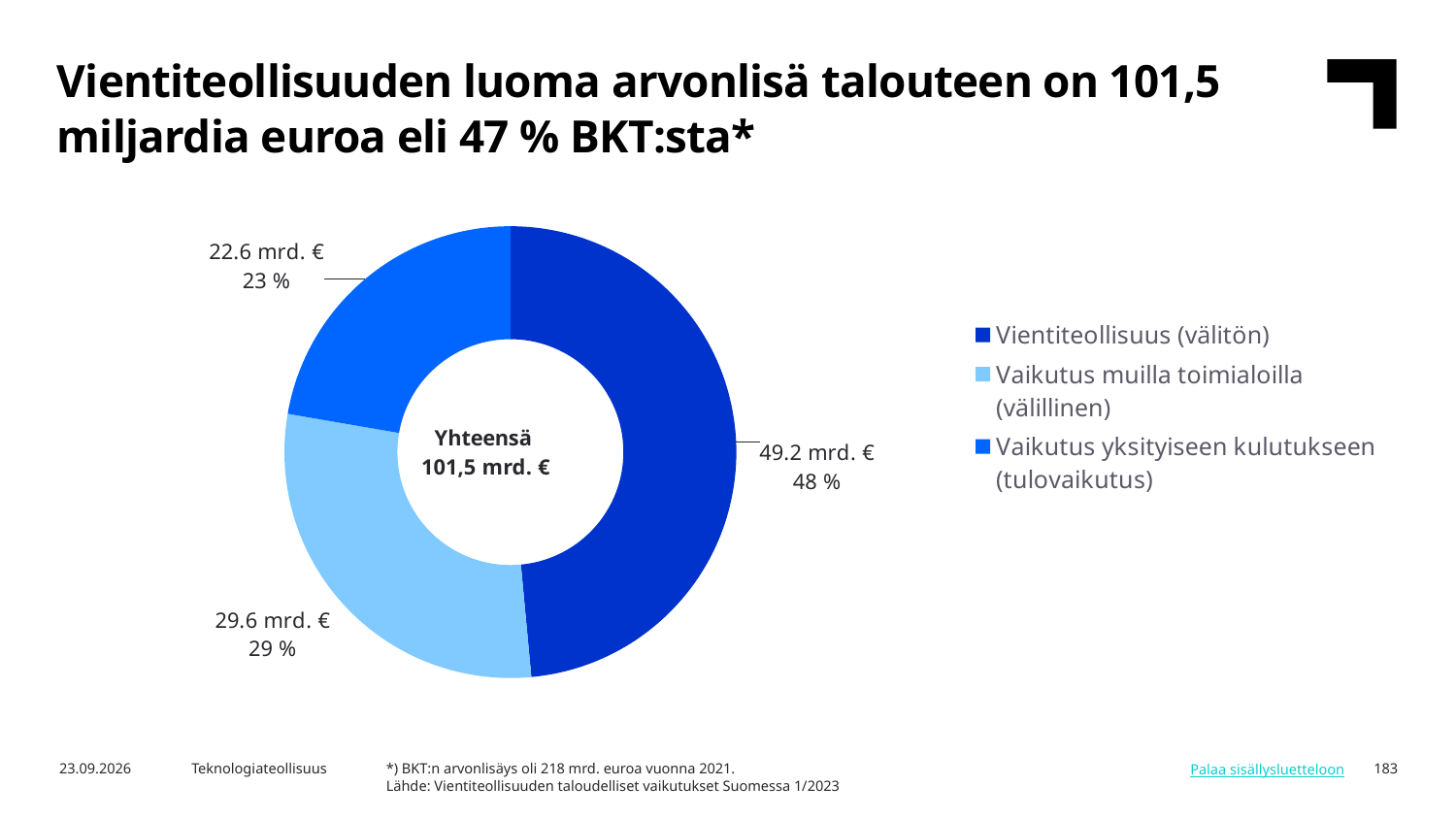
What is the difference in mrd. € between Vientiteollisuus (välitön) and Vaikutus muilla toimialoilla (välillinen)? 19.6 mrd. € What total is printed in the centre of the donut chart? Yhteensä 101,5 mrd. € How many categories does the legend list? 3 What is the value for Vaikutus yksityiseen kulutukseen (tulovaikutus)? 22.6 mrd. € What is the value for Vaikutus muilla toimialoilla (välillinen)? 29.6 mrd. € What share of the pie does Vaikutus yksityiseen kulutukseen (tulovaikutus) represent? 23 % Which is larger, Vaikutus muilla toimialoilla (välillinen) or Vaikutus yksityiseen kulutukseen (tulovaikutus)? Vaikutus muilla toimialoilla (välillinen) Which category has the smallest slice? Vaikutus yksityiseen kulutukseen (tulovaikutus) Which category has the largest slice? Vientiteollisuus (välitön) What kind of chart is shown on the slide? Pie chart (donut) What share of the pie does Vientiteollisuus (välitön) represent? 48 % What is the value for Vientiteollisuus (välitön)? 49.2 mrd. €